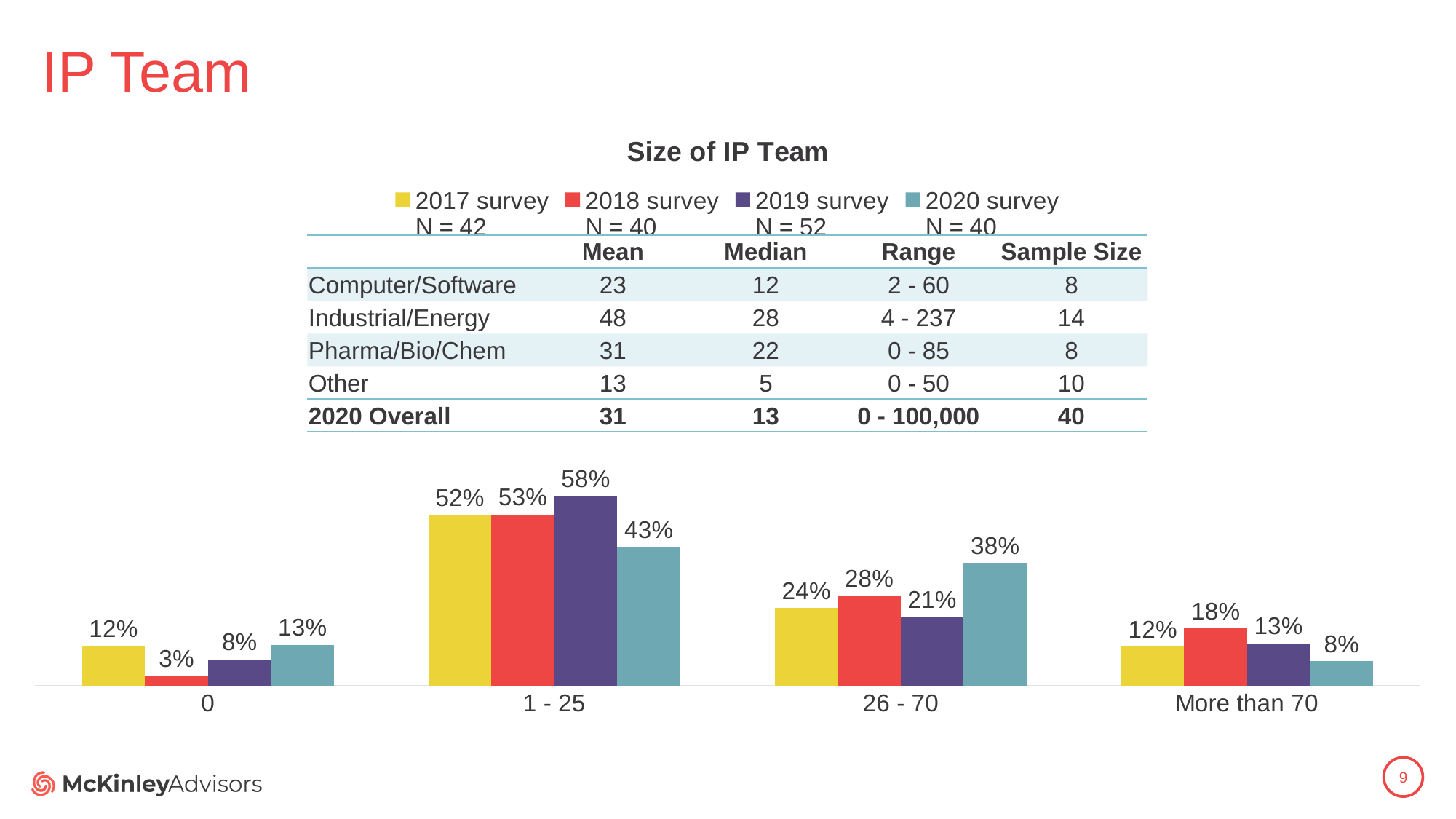
How many categories are shown on the x axis? 4 What is the value for the 2018 survey in the 0 category? 3% Which category has the lowest value for the 2018 survey? 0 How many series does the legend list? 4 Which is larger in the 26 - 70 category: the 2017 survey value or the 2018 survey value? 2018 survey What is the value for the 2017 survey in the More than 70 category? 12% What is the value for the 2019 survey in the 1 - 25 category? 58% What kind of chart is shown? Bar chart Which category has the highest value for the 2020 survey? 1 - 25 What is the value for the 2020 survey in the 26 - 70 category? 38% What is the title of the chart? Size of IP Team What is the difference between the 2019 survey and 2020 survey values in the 1 - 25 category? 15%